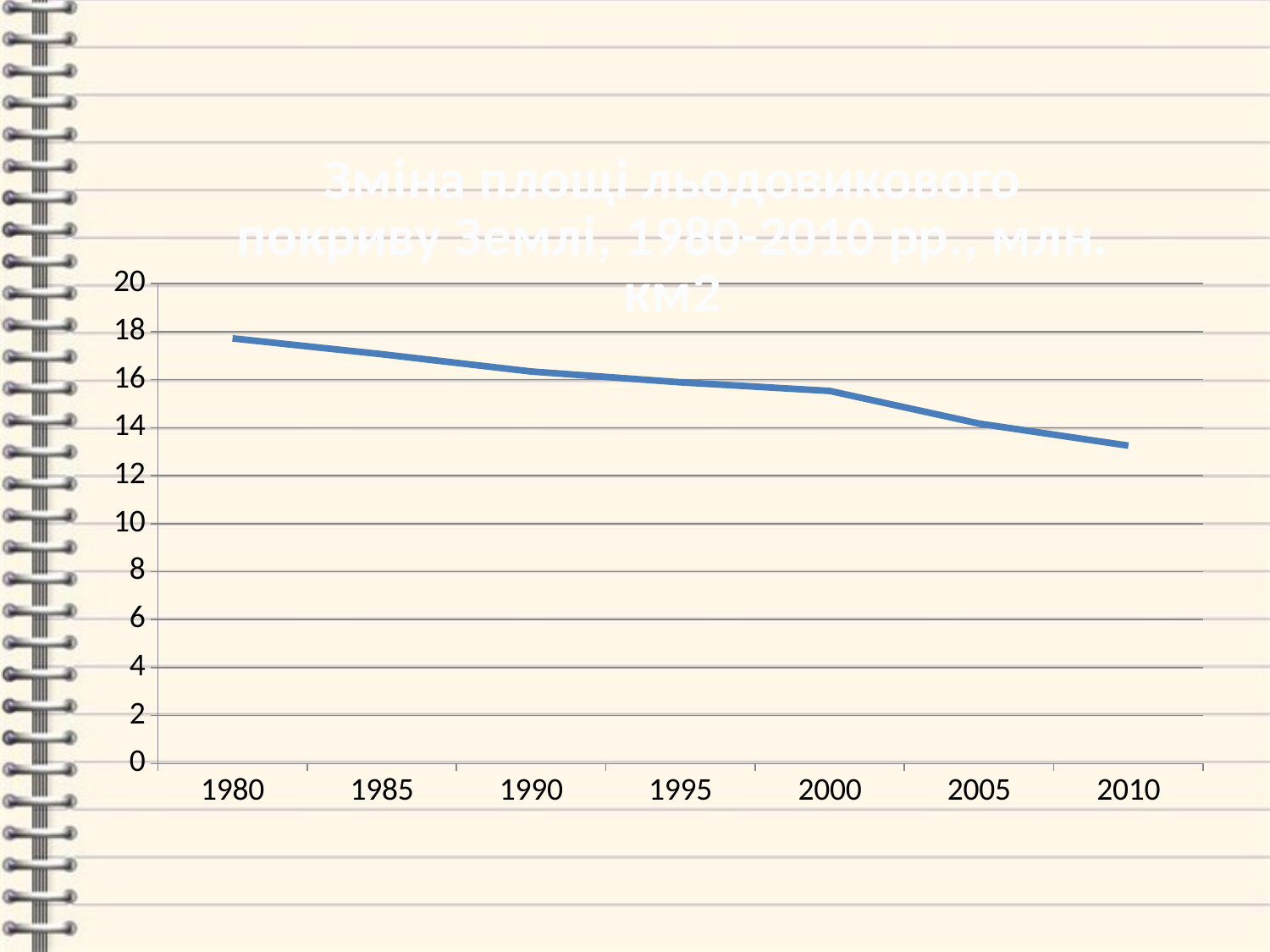
Which is larger, the value for 2000 or the value for 2010? 2000 Is the value for 1980 greater or less than 16? greater Which year has the highest value? 1980 How many years are plotted along the x axis? 7 Which year has the lowest value? 2010 What kind of chart is shown on the slide? line chart Is the value for 2010 greater or less than 14? less Do the values rise or fall from 1980 to 2010? fall What is the first year shown on the x axis? 1980 Is the value for 2000 greater or less than 14? greater Which is larger, the value for 1985 or the value for 2005? 1985